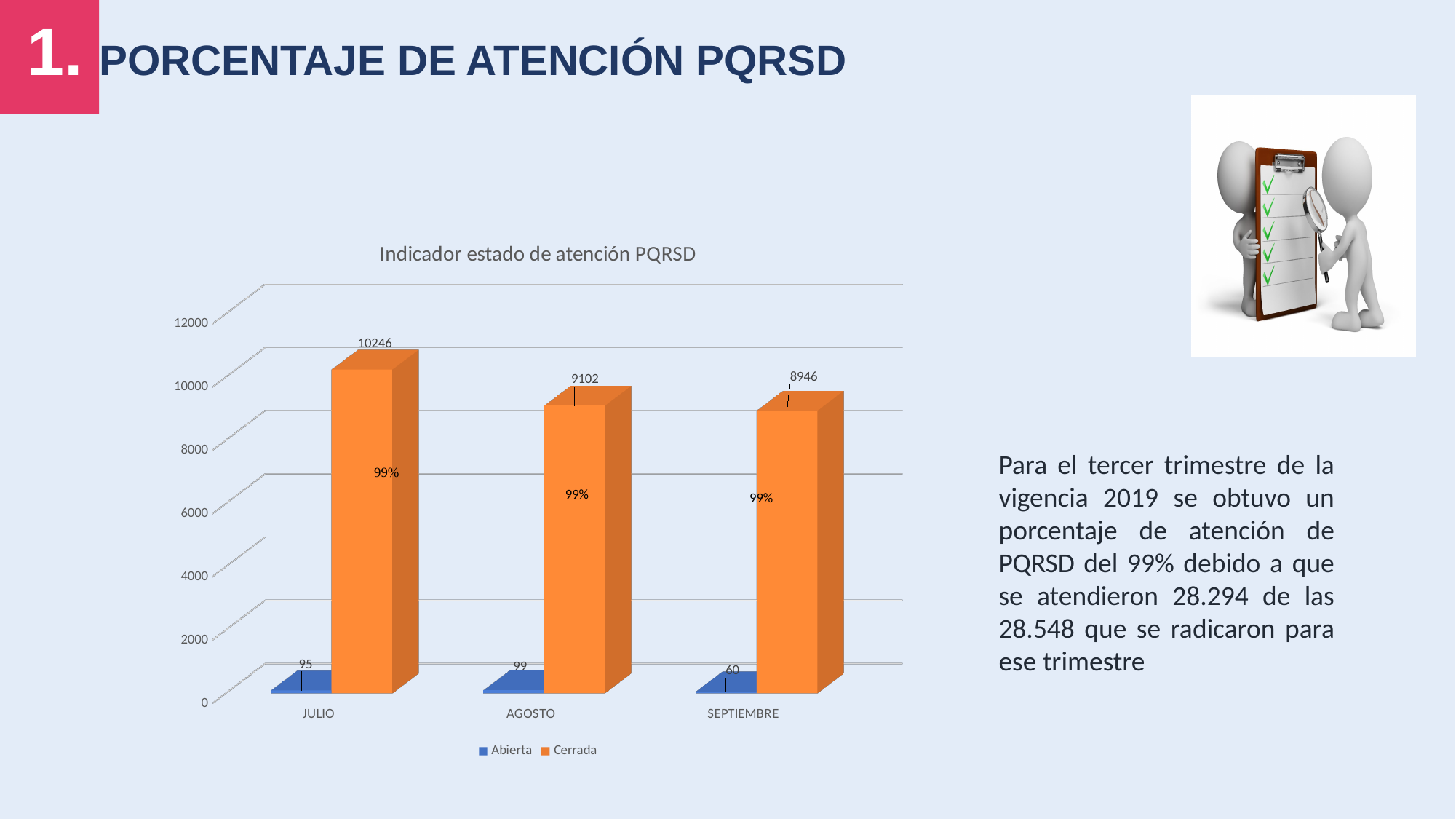
What kind of chart is shown? Bar chart How many months are shown on the x axis? 3 What is the value of Cerrada for AGOSTO? 9102 What is the difference between the Cerrada values for JULIO and SEPTIEMBRE? 1300 What is the title of the chart? Indicador estado de atención PQRSD Which month has the highest Cerrada value? JULIO Which is larger, the Cerrada value for AGOSTO or for SEPTIEMBRE? AGOSTO How many series does the legend list? 2 What is the value of Cerrada for JULIO? 10246 What is the value of Abierta for AGOSTO? 99 What is the value of Abierta for SEPTIEMBRE? 60 Which month has the lowest Abierta value? SEPTIEMBRE